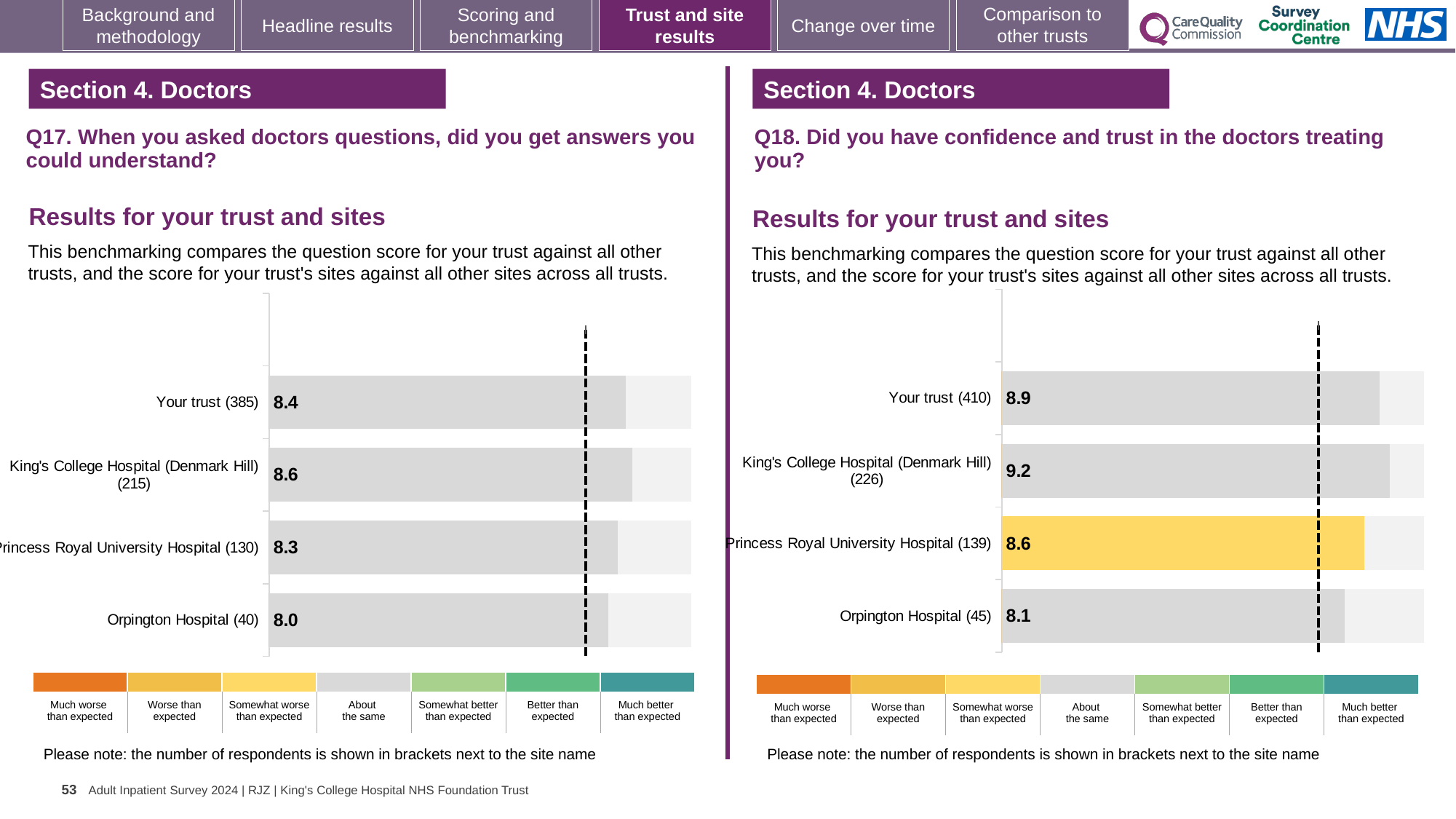
In the Q18 chart on the right, which site or trust has the lowest score? Orpington Hospital In the Q17 chart on the left, what is the difference between the scores for Your trust and Princess Royal University Hospital? 0.1 How many bars are plotted in the Q17 chart on the left? 4 What type of chart is used for the Q18 results on the right? Bar chart In the Q17 chart on the left, what is the score for Orpington Hospital? 8.0 In the Q18 chart on the right, what is the score for King's College Hospital (Denmark Hill)? 9.2 In the Q17 chart on the left, which site or trust has the highest score? King's College Hospital (Denmark Hill) In the Q18 chart on the right, how many respondents are shown in brackets for Your trust? 410 In the Q17 chart on the left, what is the score for Your trust? 8.4 In the Q18 chart on the right, which has the higher score: Your trust or Princess Royal University Hospital? Your trust In the Q18 chart on the right, what is the difference between the scores for King's College Hospital (Denmark Hill) and Orpington Hospital? 1.1 In the Q18 chart on the right, what is the score for Princess Royal University Hospital? 8.6